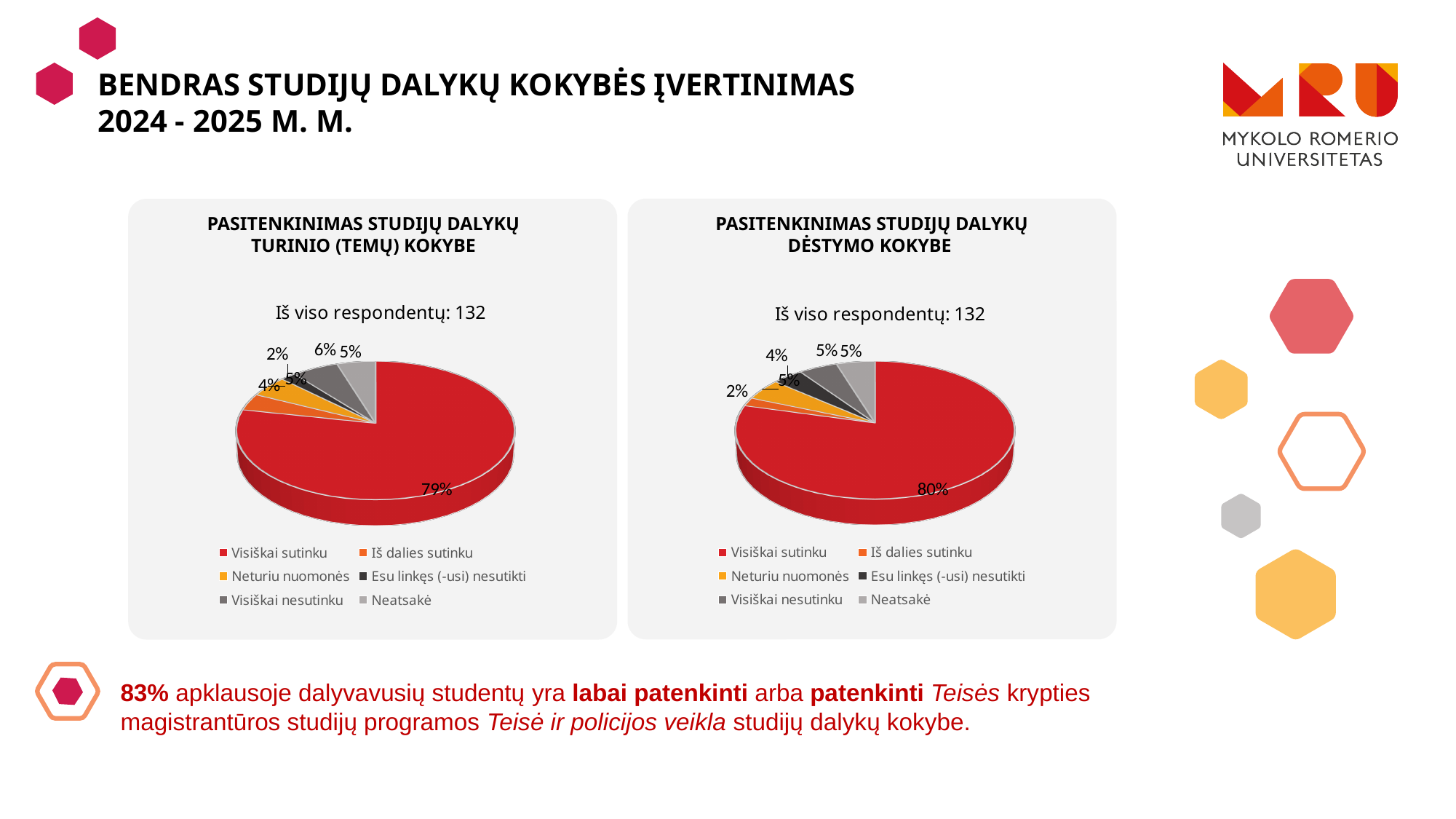
In the left chart (TURINIO (TEMŲ) KOKYBE), what share of respondents answered 'Visiškai sutinku'? 79% How many respondents are reported for the left chart (TURINIO (TEMŲ) KOKYBE)? 132 What colour represents 'Visiškai sutinku' in the right chart (DĖSTYMO KOKYBE)? Red How many categories does the legend of the right chart (DĖSTYMO KOKYBE) list? 6 In the right chart (DĖSTYMO KOKYBE), which category has the largest slice? Visiškai sutinku In the left chart (TURINIO (TEMŲ) KOKYBE), is the 'Visiškai sutinku' slice greater or less than 50% of the pie? greater Which chart has the larger 'Visiškai sutinku' share: the left chart (TURINIO (TEMŲ) KOKYBE) or the right chart (DĖSTYMO KOKYBE)? The right chart (DĖSTYMO KOKYBE) In the right chart (DĖSTYMO KOKYBE), what share of respondents answered 'Visiškai sutinku'? 80% How many categories does the legend of the left chart (TURINIO (TEMŲ) KOKYBE) list? 6 In the left chart (TURINIO (TEMŲ) KOKYBE), which category has the largest slice? Visiškai sutinku What is the difference between the 'Visiškai sutinku' share in the right chart (80%) and in the left chart (79%)? 1% What kind of chart is used on the left, titled 'PASITENKINIMAS STUDIJŲ DALYKŲ TURINIO (TEMŲ) KOKYBE'? Pie chart